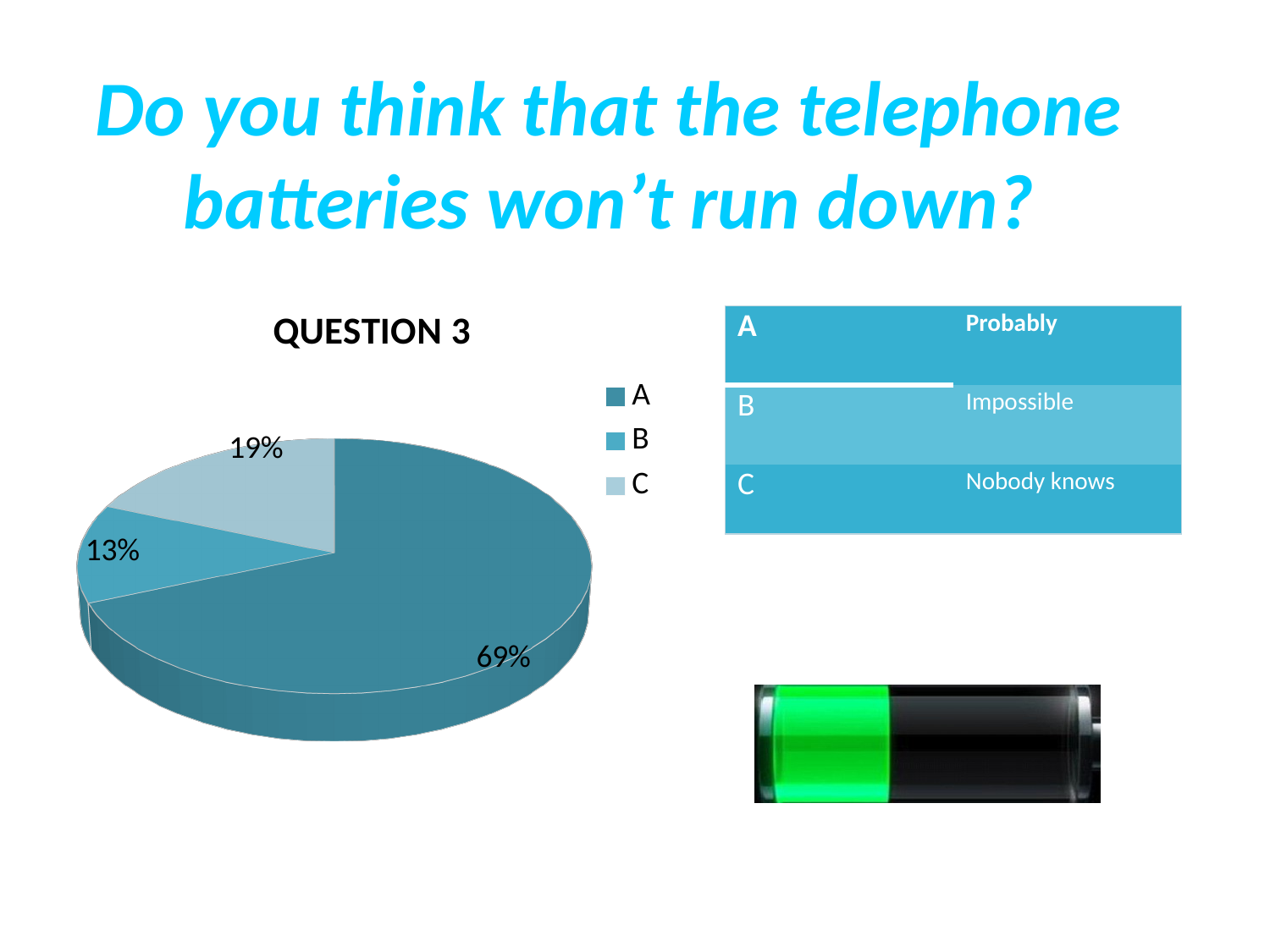
What is the chart's title? QUESTION 3 What percentage of the pie does slice B represent? 13% What percentage of the pie does slice C represent? 19% How many slices does the pie chart have? 3 Which is larger, slice B or slice C? C How many entries does the legend list? 3 Which slice is the largest? A What percentage of the pie does slice A represent? 69% Which slice is the smallest? B What is the difference in percentage points between slice A and slice C? 50 What type of chart is shown on the slide? pie chart What is the difference in percentage points between slice C and slice B? 6